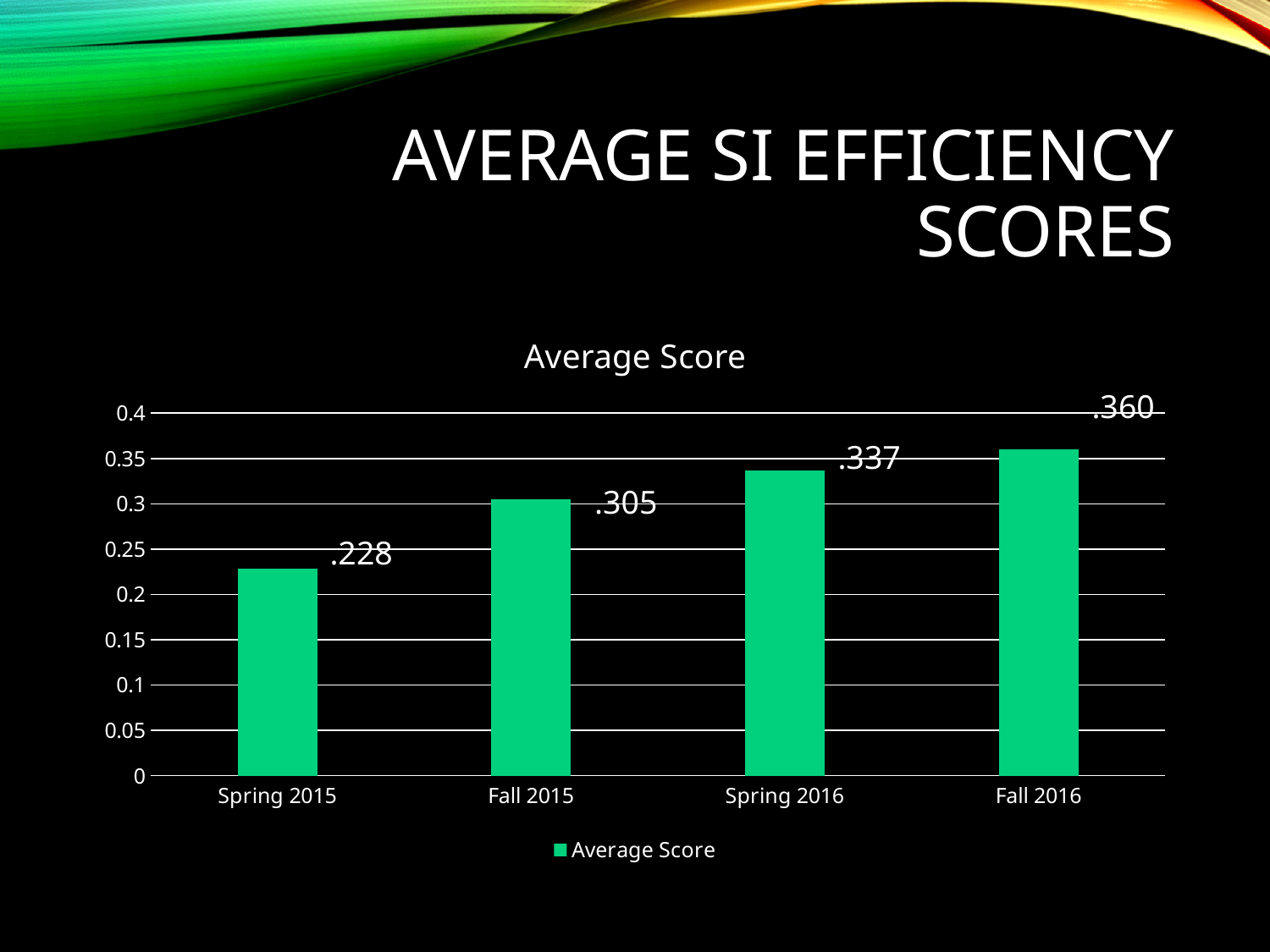
What is the difference between the average scores for Fall 2015 and Spring 2015? .077 Is the value for Fall 2015 greater or less than 0.25? greater What is the difference between the average scores for Fall 2016 and Spring 2015? .132 Which term has the lowest average score? Spring 2015 Which is larger, the average score for Fall 2015 or Spring 2016? Spring 2016 Do the average scores rise or fall from Spring 2015 to Fall 2016? rise What is the average score for Spring 2015? .228 How many terms are shown on the x axis? 4 What is the average score for Fall 2016? .360 What kind of chart is shown on the slide? bar chart Which term has the highest average score? Fall 2016 What is the average score for Spring 2016? .337